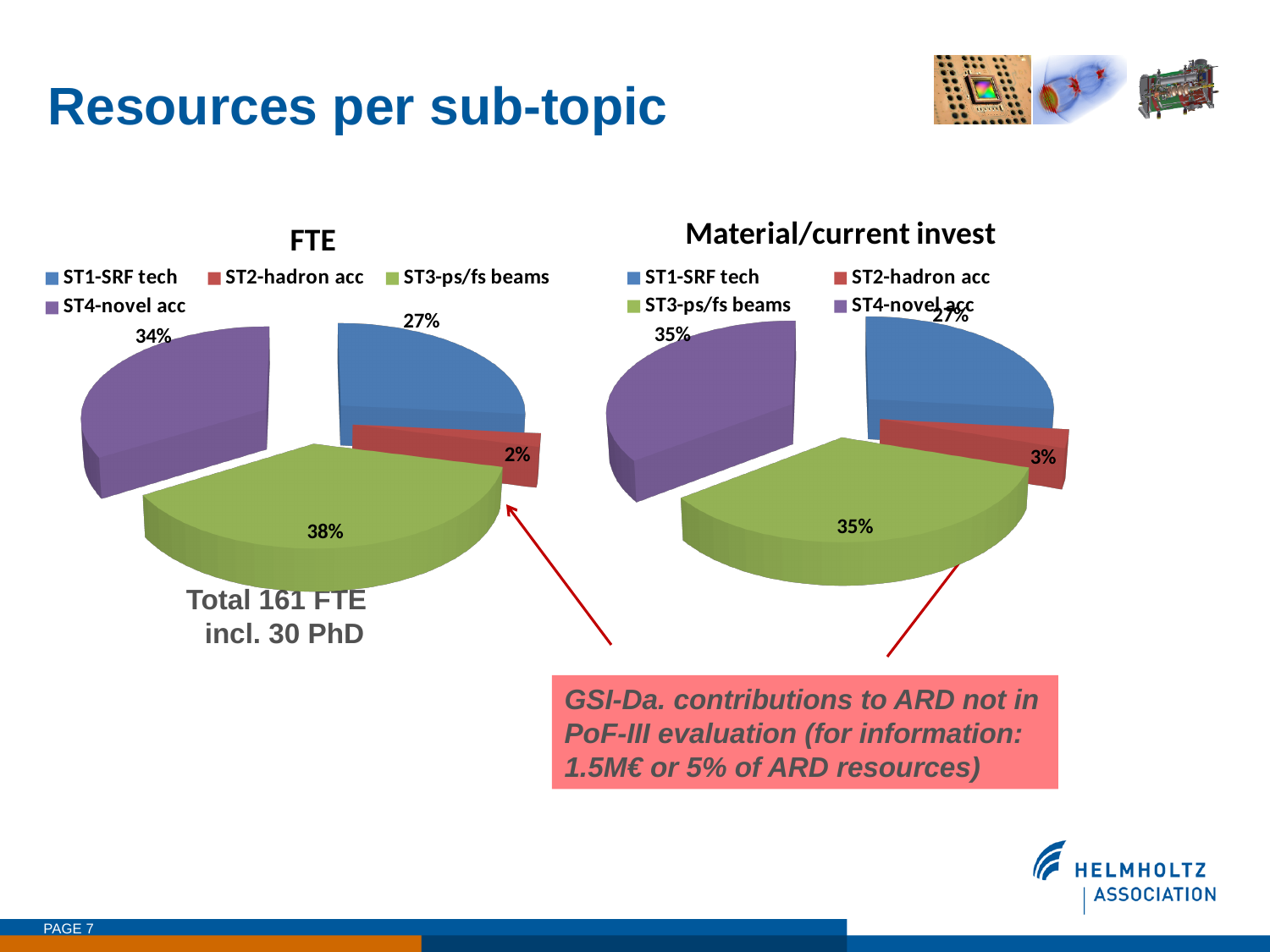
How many categories does the legend of the FTE chart list? 4 In the Material/current invest chart, what share does ST2-hadron acc have? 3% In the FTE chart, which sub-topic has the smallest share? ST2-hadron acc In the Material/current invest chart, which is larger, the share of ST3-ps/fs beams or the share of ST1-SRF tech? ST3-ps/fs beams In the Material/current invest chart, which sub-topic has the smallest share? ST2-hadron acc In the FTE chart, which sub-topic has the largest share? ST3-ps/fs beams In the Material/current invest chart, what share does ST1-SRF tech have? 27% In the FTE chart, which colour represents ST4-novel acc? Purple In the FTE chart, what share does ST4-novel acc have? 34% What type of chart is the Material/current invest chart? Pie chart In the FTE chart, what is the difference between the shares of ST3-ps/fs beams and ST1-SRF tech? 11%